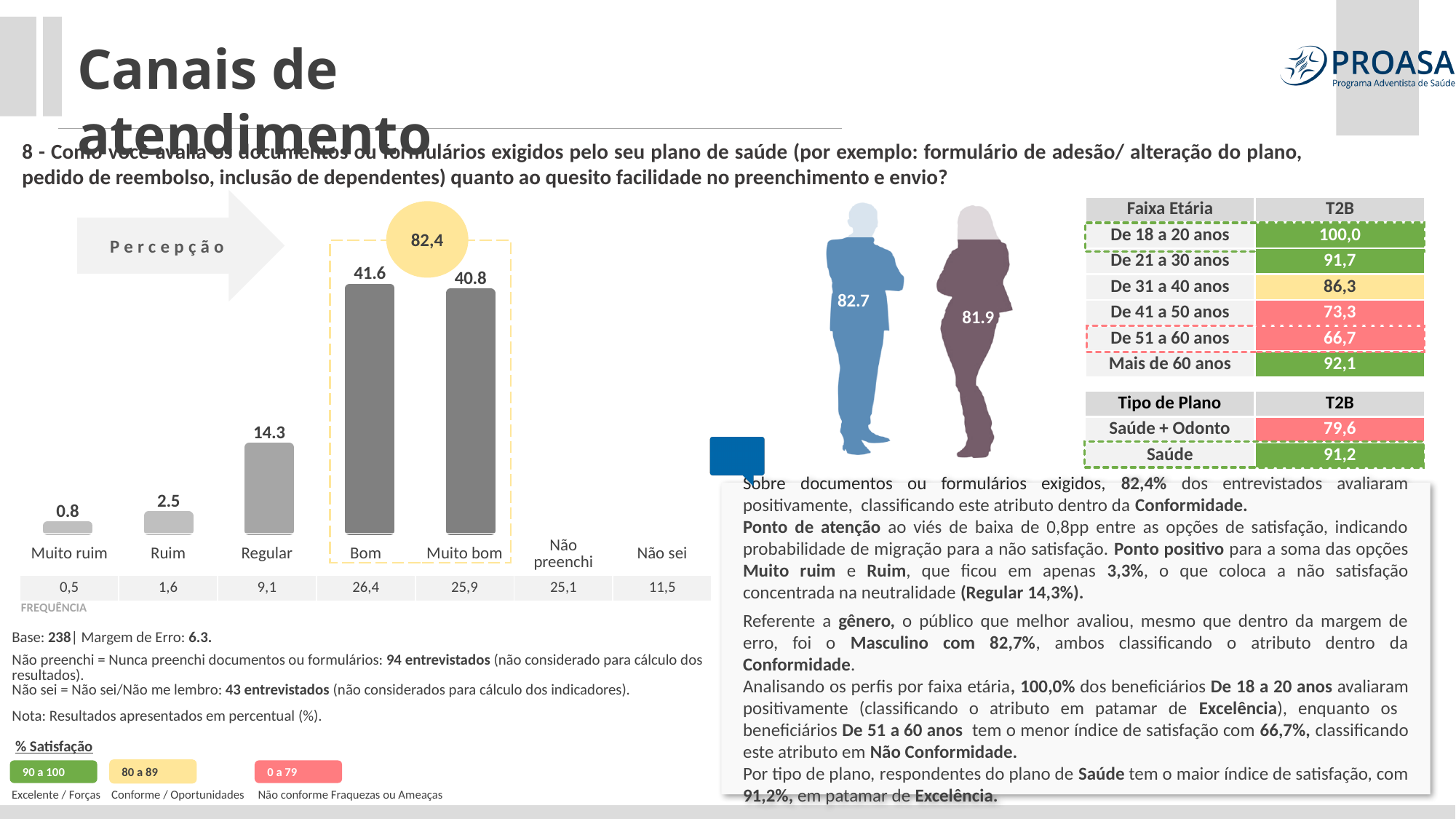
Which is larger, the value for Regular or the value for Ruim? Regular Which category has the lowest bar in the chart? Muito ruim What kind of chart is shown on the slide? bar chart What is the difference between the values for Bom and Muito bom? 0.8 What value is shown in the yellow circle above the Bom and Muito bom bars? 82,4 What is the difference between the values for Regular and Ruim? 11.8 What is the value for Muito bom in the bar chart? 40.8 Which category has the highest bar in the chart? Bom What is the value for Bom in the bar chart? 41.6 What is the value for Muito ruim in the bar chart? 0.8 What is the value for Regular in the bar chart? 14.3 What is the value for Ruim in the bar chart? 2.5